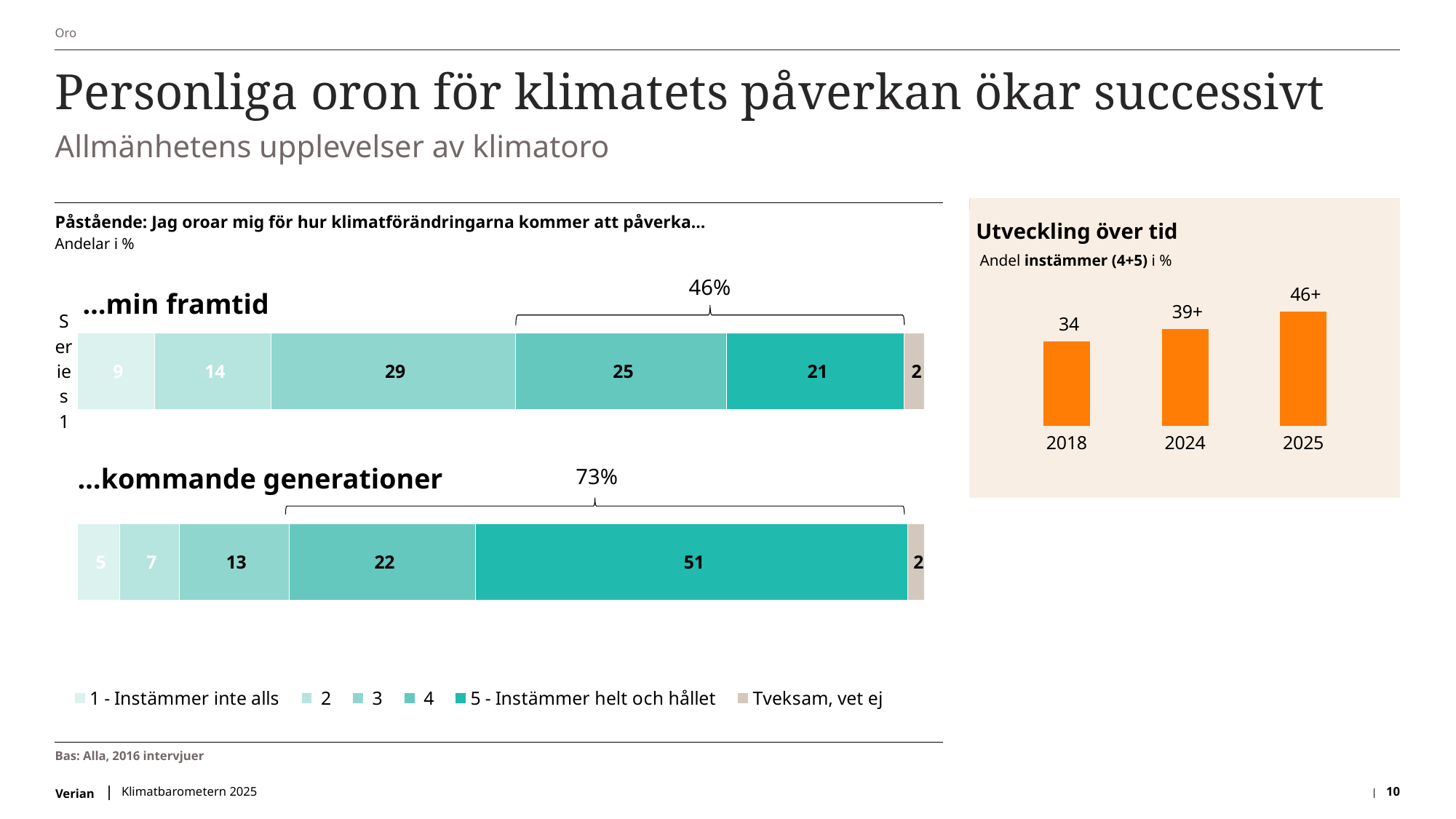
In the "...kommande generationer" stacked bar chart, which segment has the smallest value? Tveksam, vet ej Which is larger: the value for "4" in the "...min framtid" chart or the value for "4" in the "...kommande generationer" chart? ...min framtid In the "Utveckling över tid" chart, do the values rise or fall from 2018 to 2025? rise How many entries does the legend below the stacked bar charts list? 6 In the "Utveckling över tid" chart, what is the value for 2025? 46+ In the "...min framtid" stacked bar chart, what is the value for "1 - Instämmer inte alls"? 9 In the "...min framtid" stacked bar chart, which segment has the largest value? 3 What is the difference between the "5 - Instämmer helt och hållet" values in the "...kommande generationer" chart and the "...min framtid" chart? 30 In the "...kommande generationer" stacked bar chart, what is the value for "5 - Instämmer helt och hållet"? 51 In the "...kommande generationer" stacked bar chart, what is the value for "Tveksam, vet ej"? 2 In the "...min framtid" stacked bar chart, what is the value for "5 - Instämmer helt och hållet"? 21 In the "Utveckling över tid" chart, what is the value for 2018? 34